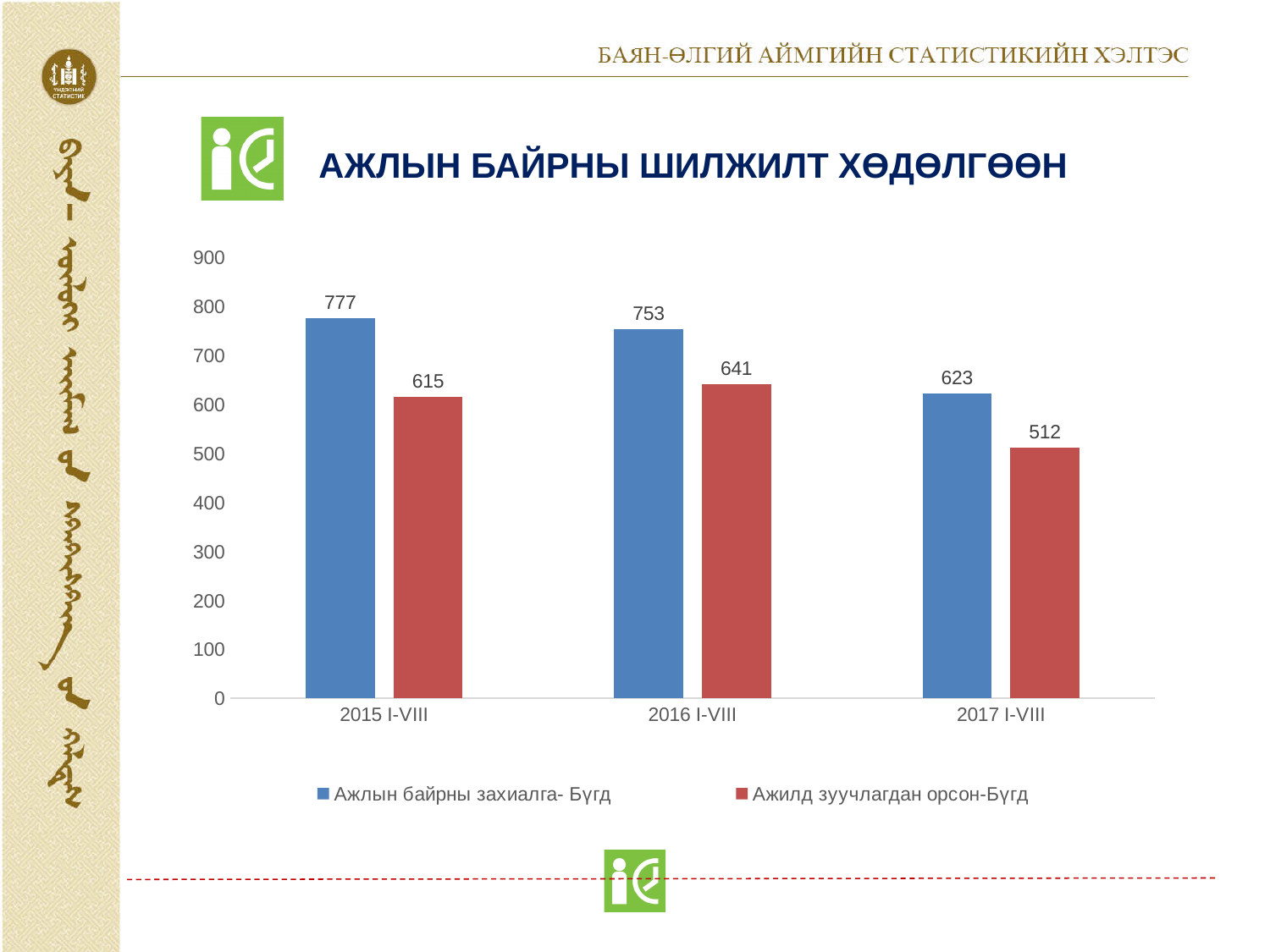
Does Ажлын байрны захиалга- Бүгд rise or fall from 2015 I-VIII to 2017 I-VIII? Fall Is the value of Ажлын байрны захиалга- Бүгд for 2016 I-VIII greater or less than 700? greater How many periods are shown on the x axis? 3 What is the difference between Ажлын байрны захиалга- Бүгд and Ажилд зуучлагдан орсон-Бүгд in 2015 I-VIII? 162 How many series does the legend list? 2 Which is larger: Ажилд зуучлагдан орсон-Бүгд in 2016 I-VIII or Ажлын байрны захиалга- Бүгд in 2017 I-VIII? Ажилд зуучлагдан орсон-Бүгд in 2016 I-VIII In which period is Ажлын байрны захиалга- Бүгд highest? 2015 I-VIII What is the value of Ажилд зуучлагдан орсон-Бүгд for 2016 I-VIII? 641 What is the value of Ажилд зуучлагдан орсон-Бүгд for 2017 I-VIII? 512 What is the value of Ажлын байрны захиалга- Бүгд for 2015 I-VIII? 777 In which period is Ажилд зуучлагдан орсон-Бүгд lowest? 2017 I-VIII What kind of chart is shown on the slide? Bar chart